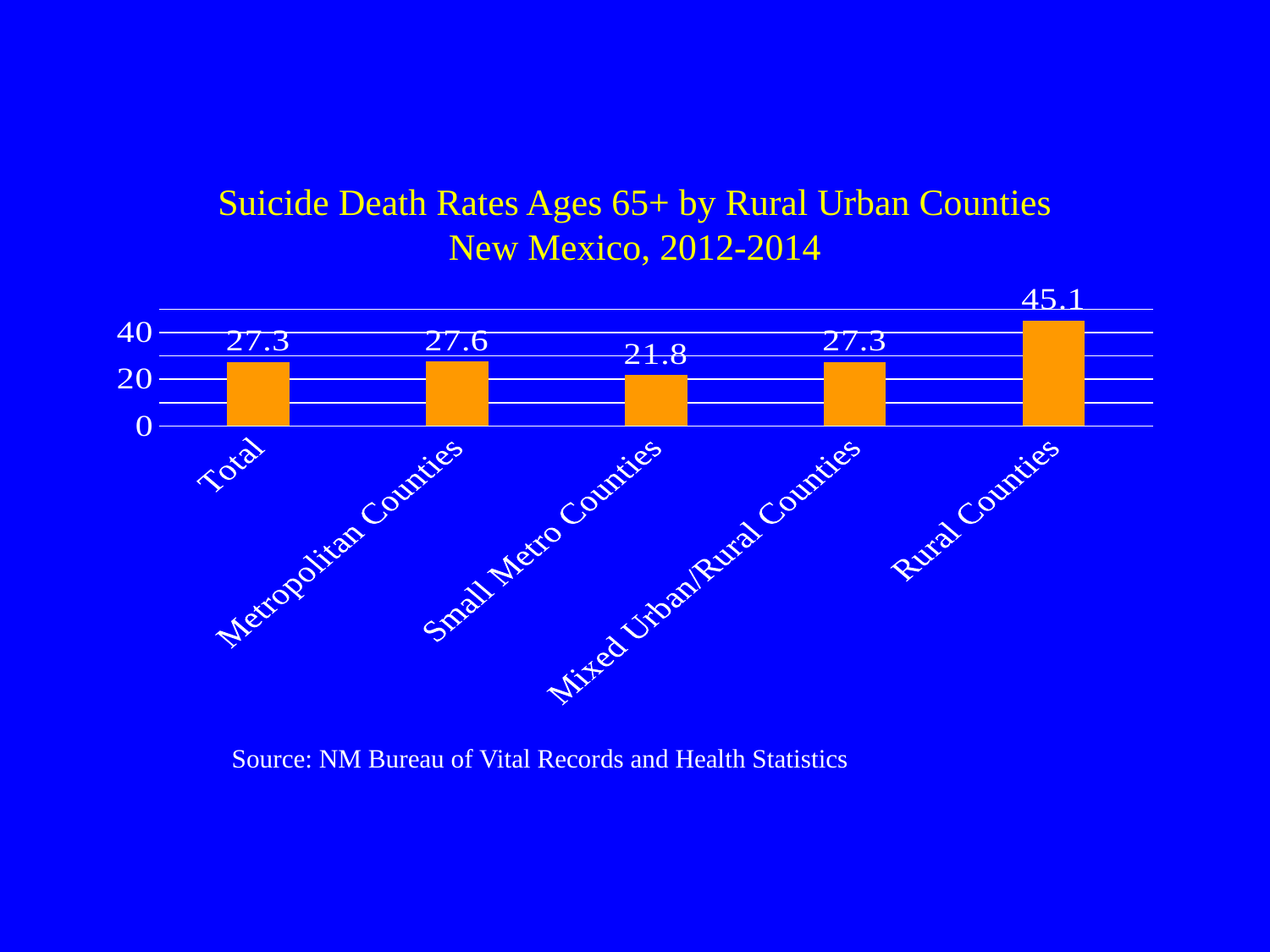
What is the suicide death rate for Small Metro Counties? 21.8 Which category has the highest suicide death rate? Rural Counties What is the suicide death rate for Metropolitan Counties? 27.6 What is the suicide death rate for Rural Counties? 45.1 What kind of chart is shown on the slide? Bar chart Which category has the lowest suicide death rate? Small Metro Counties What is the difference between the rates for Rural Counties and Metropolitan Counties? 17.5 What is the value shown for Total? 27.3 What is the difference between the rates for Rural Counties and Small Metro Counties? 23.3 Is the value for Rural Counties greater or less than 40? greater How many categories are shown on the x axis? 5 Which is larger, the rate for Rural Counties or the rate for Mixed Urban/Rural Counties? Rural Counties